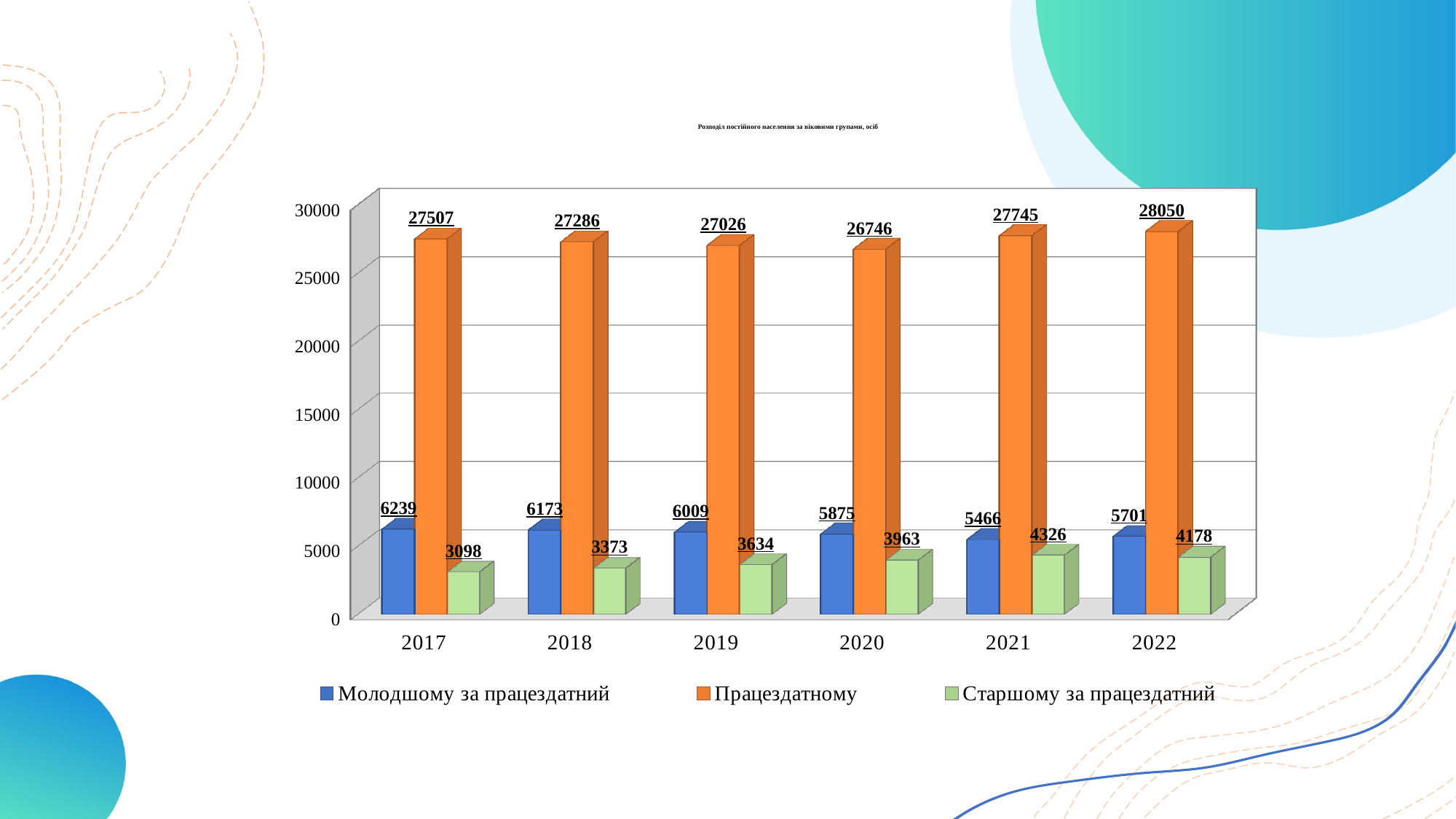
How many years are shown on the x axis? 6 What kind of chart is shown on the slide? bar chart Which is larger: Молодшому за працездатний in 2021 or in 2022? 2022 What is the value for Молодшому за працездатний in 2017? 6239 What is the value for Працездатному in 2022? 28050 What is the value for Старшому за працездатний in 2020? 3963 What colour are the bars for the Працездатному series? orange Does the Старшому за працездатний value rise or fall from 2017 to 2021? rise What is the difference between the Працездатному values in 2022 and 2021? 305 In which year is the Працездатному value lowest? 2020 In which year is the Старшому за працездатний value highest? 2021 How many series does the legend list? 3